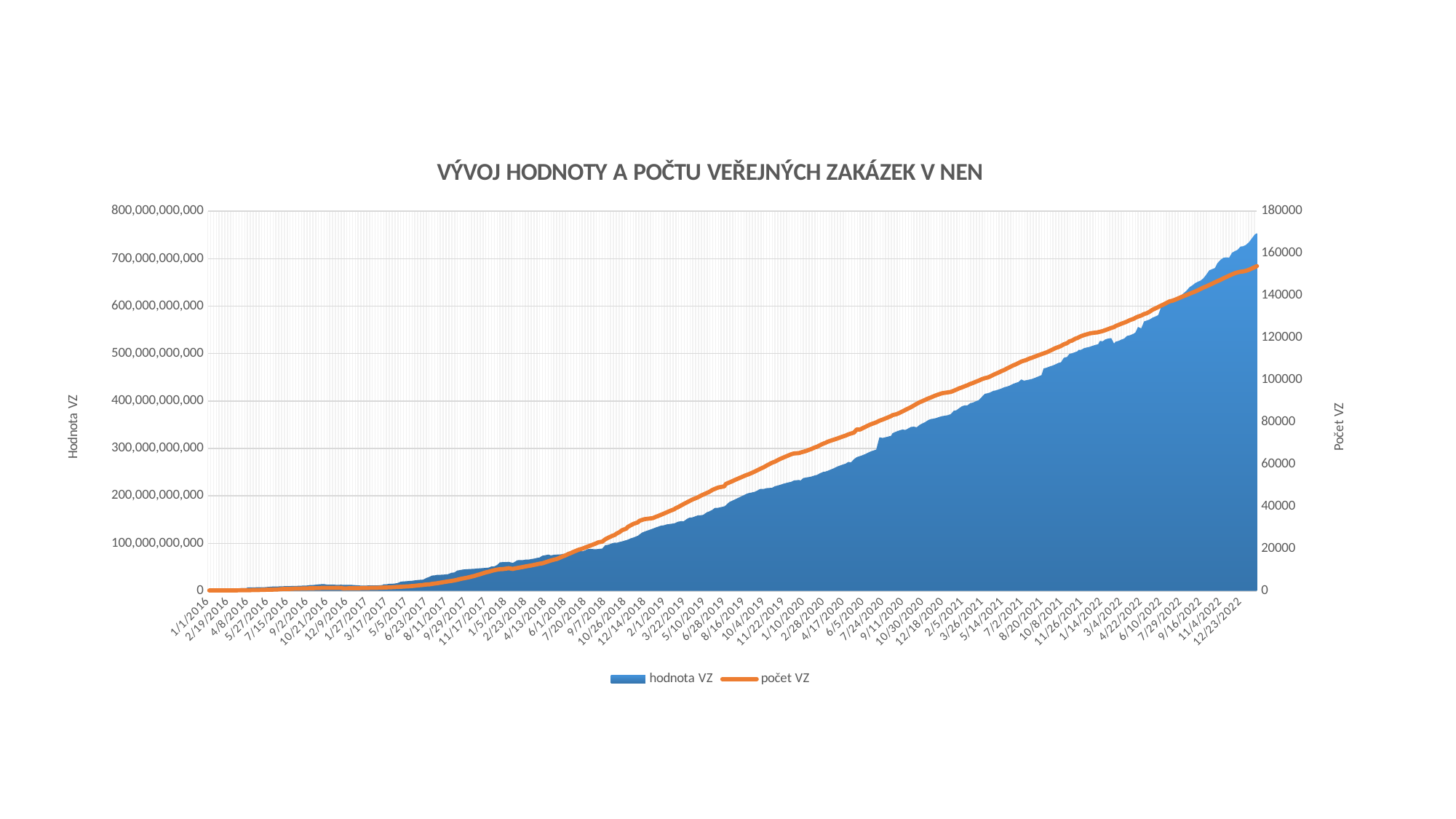
Is the value of hodnota VZ at 12/23/2022 greater or less than 700,000,000,000? greater Is the value of počet VZ at 6/28/2019 greater or less than 40000? greater Does the hodnota VZ series rise or fall from 1/1/2016 to 12/23/2022? rise Is the value of hodnota VZ at 1/10/2020 greater or less than 300,000,000,000? less Does the počet VZ series rise or fall over the period shown? rise Which series is drawn as an orange line? počet VZ How many series does the legend list? 2 What kind of chart is this? A combination of an area chart and a line chart What is the title of the chart? VÝVOJ HODNOTY A POČTU VEŘEJNÝCH ZAKÁZEK V NEN